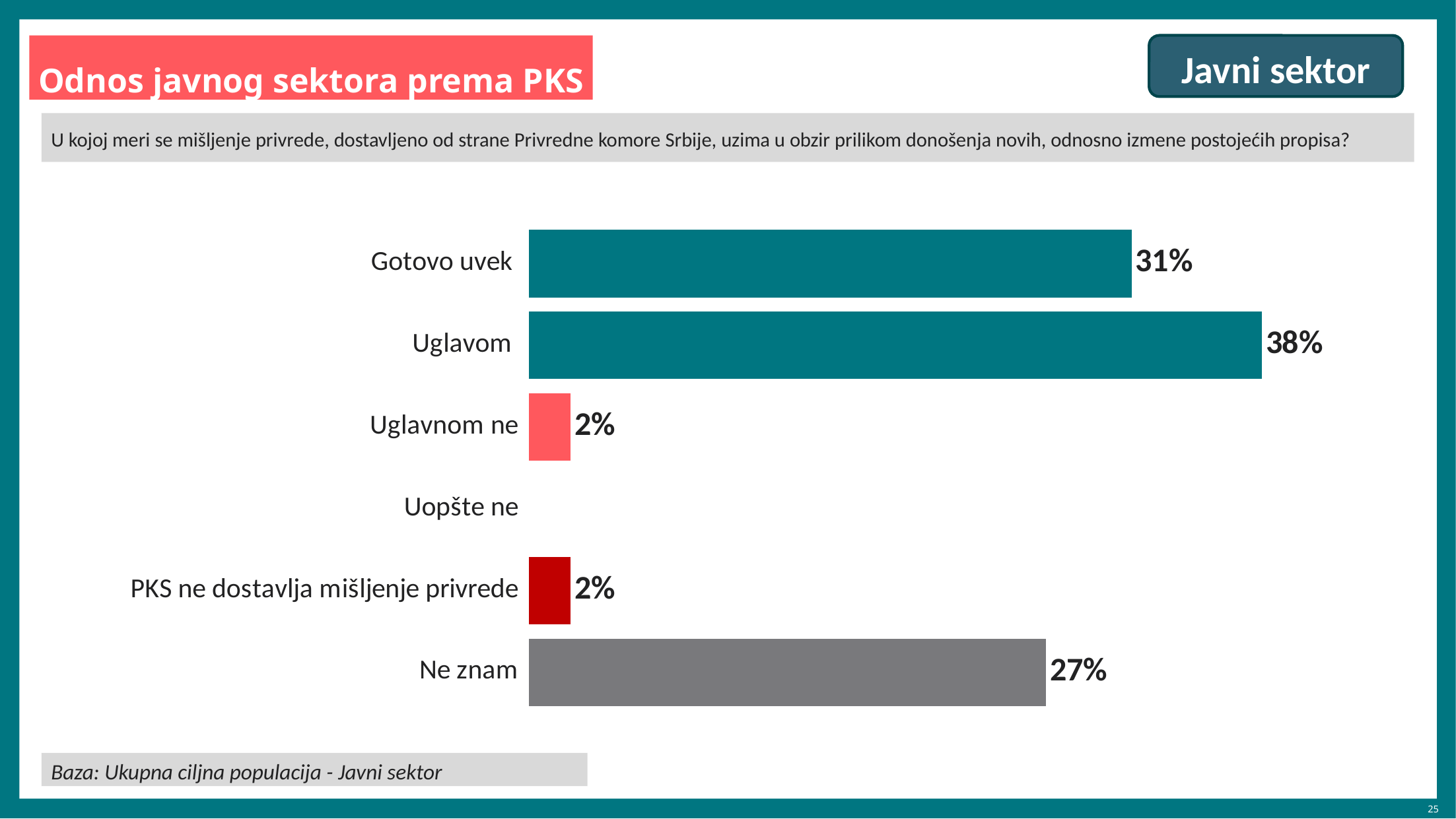
What kind of chart is shown on the slide? Bar chart How many categories are listed on the chart? 6 What is the difference in percentage points between "Uglavom" and "Gotovo uvek"? 7 percentage points What is the combined percentage for "Gotovo uvek" and "Uglavom"? 69% What percentage is shown for "Ne znam"? 27% What is the title of the slide? Odnos javnog sektora prema PKS What value is shown for "PKS ne dostavlja mišljenje privrede"? 2% What value is shown for "Uglavnom ne"? 2% What percentage is shown for "Gotovo uvek"? 31% Which category has the highest value? Uglavom What value is shown for "Uglavom"? 38% Which is larger, the value for "Gotovo uvek" or the value for "Ne znam"? Gotovo uvek